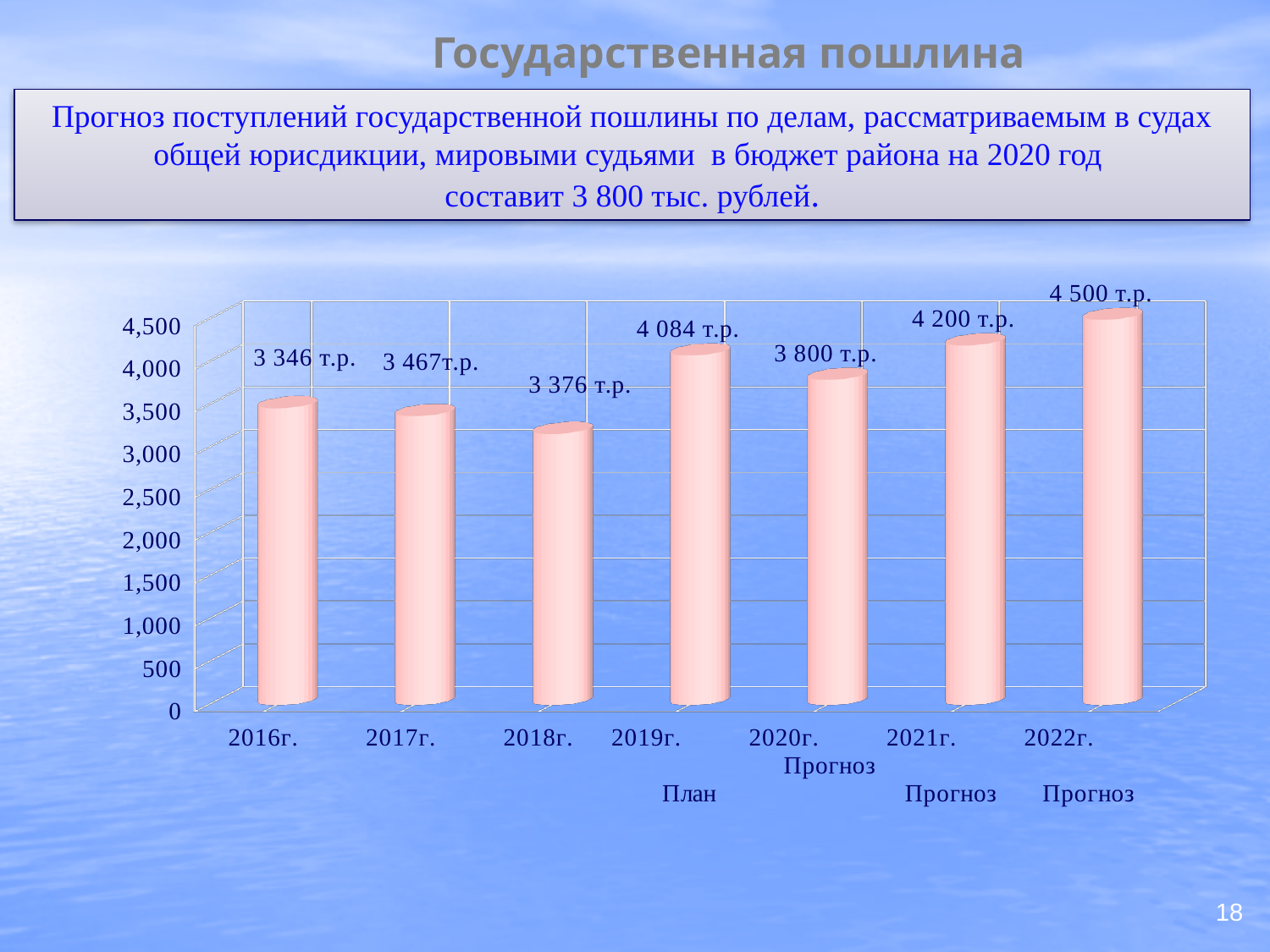
What is the difference between the values for 2017г. and 2016г.? 121 т.р. What is the value for 2019г. План? 4 084 т.р. Is the value for 2018г. greater or less than 3,500? less What is the value for 2016г.? 3 346 т.р. What is the value for 2020г. Прогноз? 3 800 т.р. How many years are shown on the x axis? 7 What is the difference between the values for 2021г. and 2020г.? 400 т.р. What is the value for 2022г. Прогноз? 4 500 т.р. Which is larger, the value for 2019г. or the value for 2020г.? 2019г. Which year has the highest value? 2022г. What kind of chart is shown on the slide? bar chart